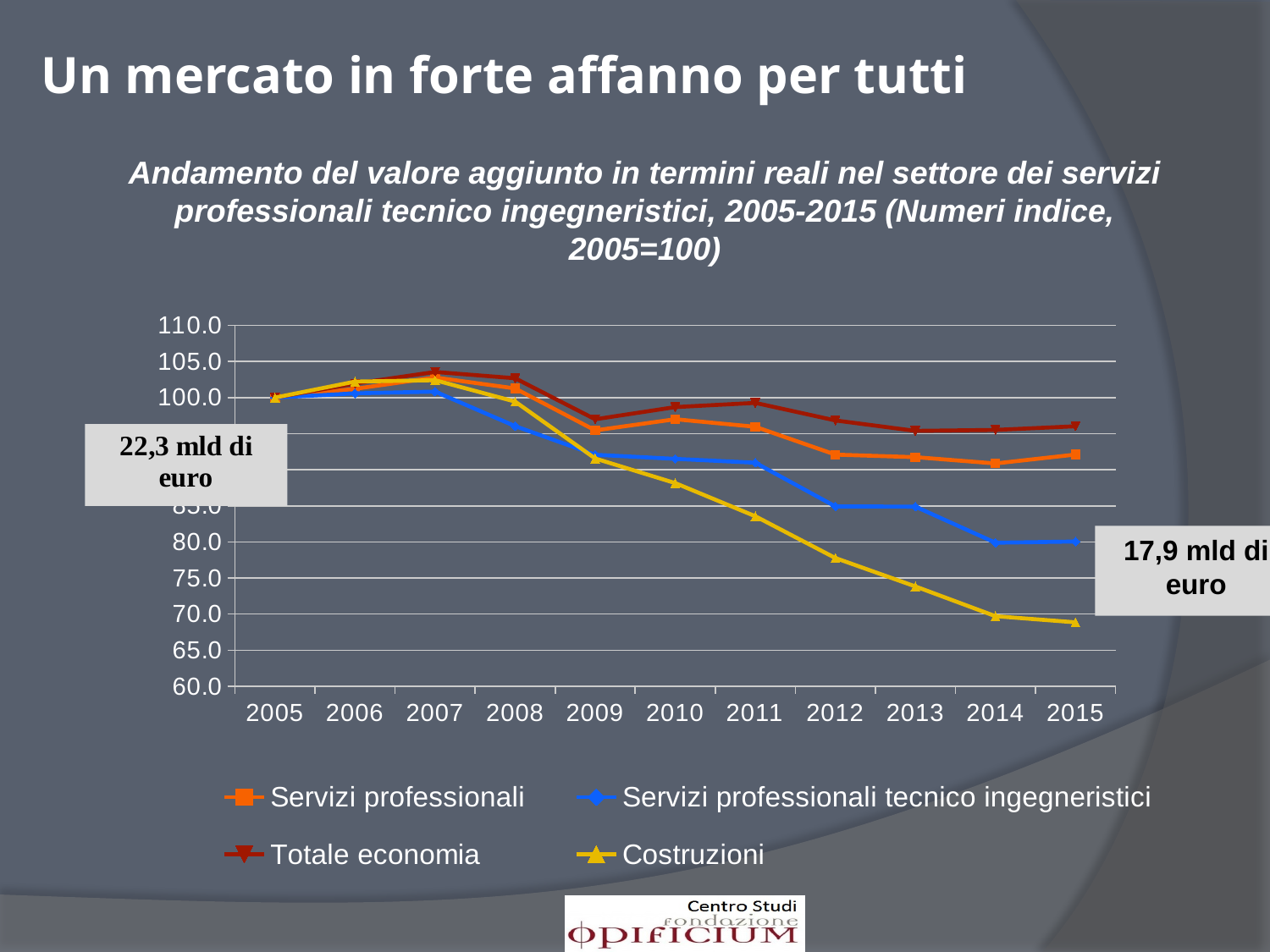
Is the value for Servizi professionali in 2015 greater or less than 90.0? greater How many years are shown on the x axis? 11 In 2015, which is larger: Servizi professionali or Servizi professionali tecnico ingegneristici? Servizi professionali What kind of chart is shown on the slide? line chart What amount is shown in the text box on the right side of the chart? 17,9 mld di euro How many series does the legend list? 4 Is the value for Costruzioni in 2012 greater or less than 80.0? less Is the value for Totale economia in 2007 greater or less than 100.0? greater Which series has the highest value in 2015? Totale economia Which series has the lowest value in 2015? Costruzioni Does the Costruzioni series rise or fall from 2007 to 2015? fall What is the value for Costruzioni in 2005? 100.0